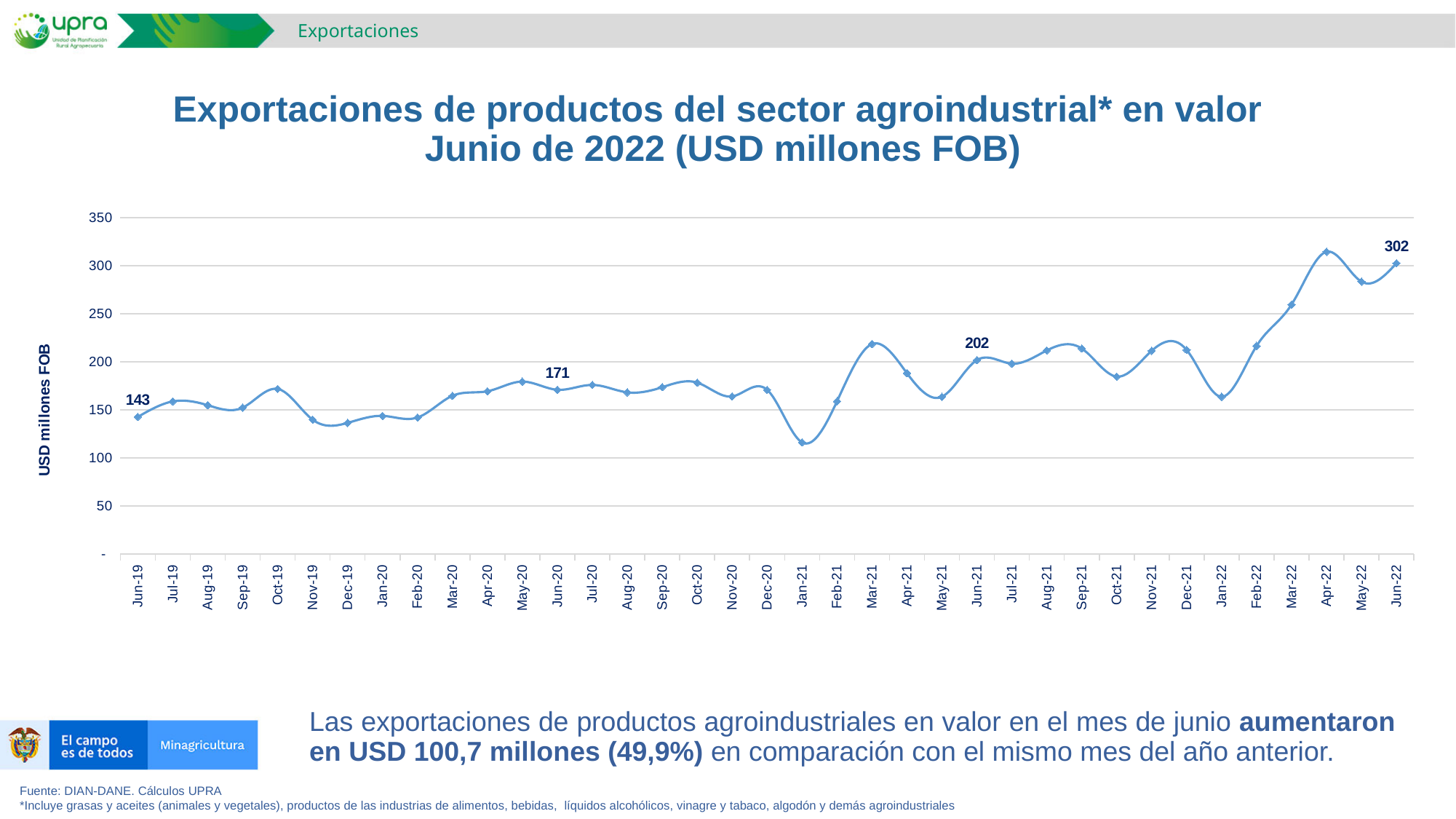
Which month has the lowest value on the chart? Jan-21 What is the value for Jun-22? 302 What is the difference between the values for Jun-22 and Jun-21? 100 How many monthly data points are plotted on the chart? 37 What kind of chart is shown on the slide? line chart What is the label of the vertical axis? USD millones FOB What is the value for Jun-20? 171 What is the value for Jun-21? 202 Is the value for Jan-21 greater or less than 150? less Which is larger, the value for Jun-22 or the value for Jun-19? Jun-22 Is the value for Apr-22 greater or less than 300? greater What is the value for Jun-19? 143